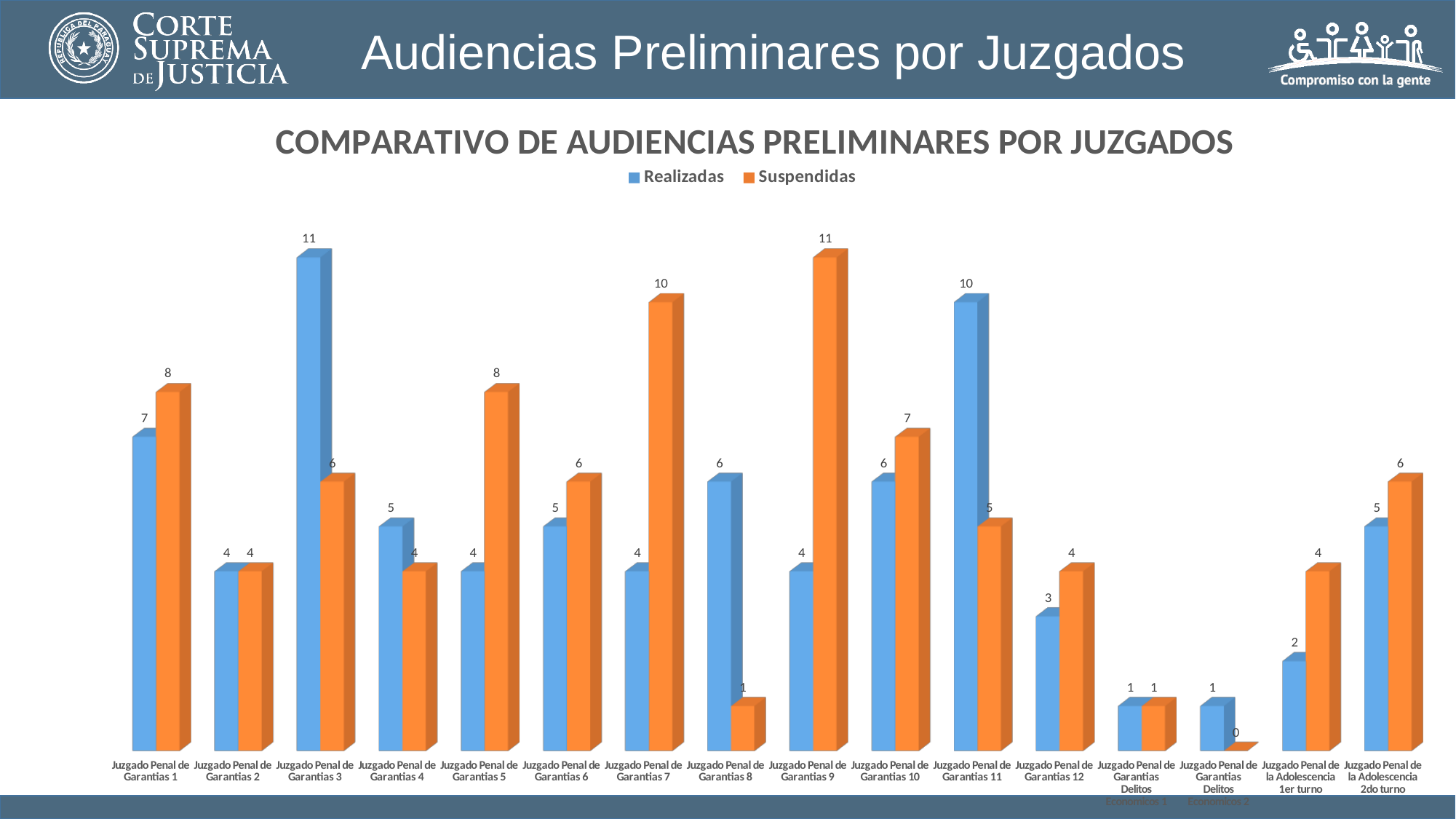
Which category has the highest Realizadas value? Juzgado Penal de Garantias 3 For Juzgado Penal de Garantias 5, which is larger, Realizadas or Suspendidas? Suspendidas What is the Realizadas value for Juzgado Penal de Garantias 1? 7 How many series does the legend list? 2 How many categories (juzgados) are shown on the x axis? 16 What is the Realizadas value for Juzgado Penal de la Adolescencia 1er turno? 2 What type of chart is shown? Bar chart Which category has the highest Suspendidas value? Juzgado Penal de Garantias 9 What is the difference between Suspendidas and Realizadas for Juzgado Penal de Garantias 9? 7 For Juzgado Penal de Garantias 8, which is larger, Realizadas or Suspendidas? Realizadas What is the difference between Realizadas and Suspendidas for Juzgado Penal de Garantias 11? 5 What is the Suspendidas value for Juzgado Penal de Garantias 7? 10